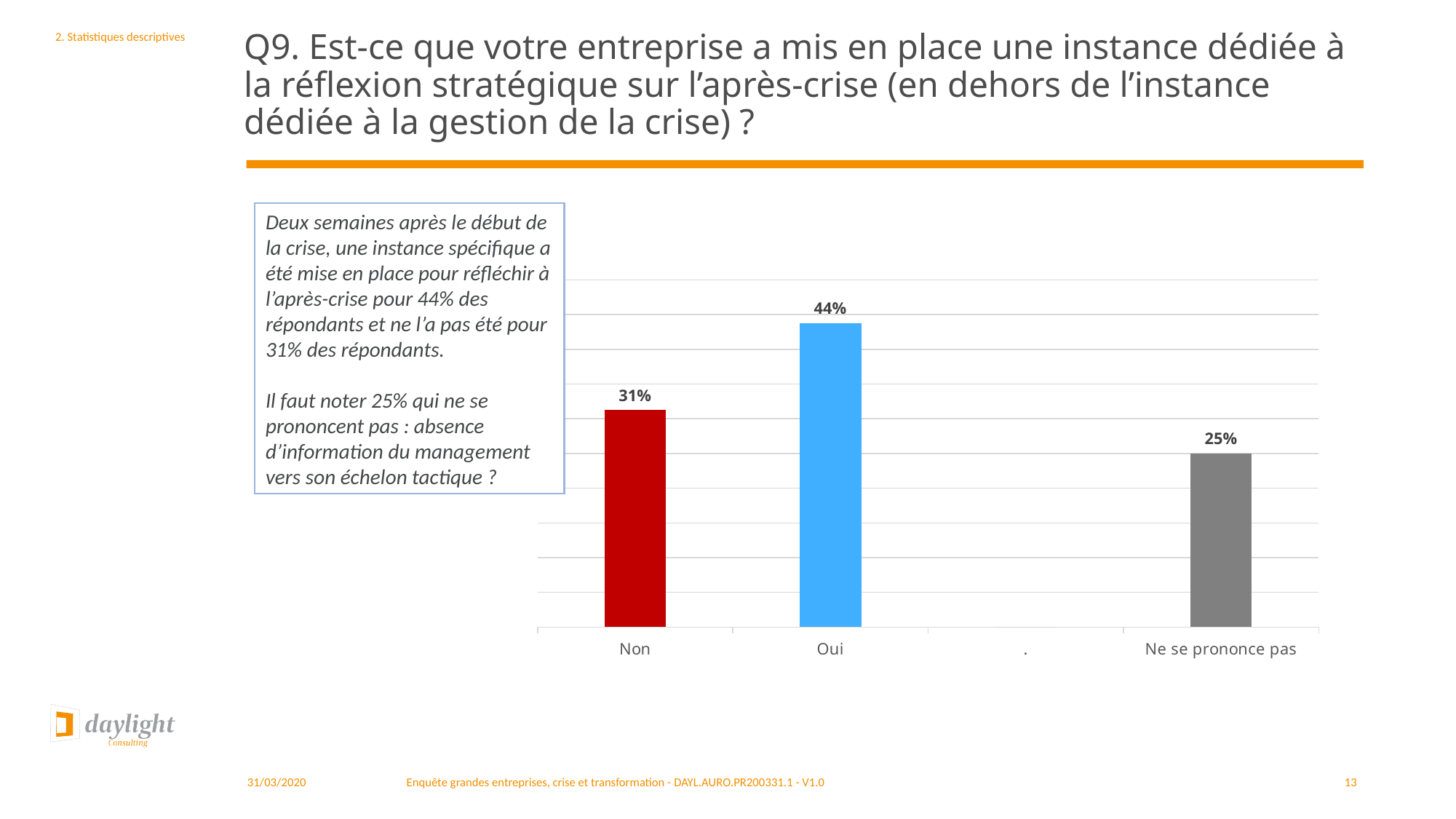
Which category has the lowest value among the plotted bars? Ne se prononce pas Which category has the highest value? Oui Which is larger, the value for "Non" or the value for "Ne se prononce pas"? Non What is the difference between the values for "Non" and "Ne se prononce pas"? 6% What is the value for "Ne se prononce pas"? 25% How many bars are plotted on the chart? 3 What colour is the bar for "Non"? Red What is the difference between the values for "Oui" and "Non"? 13% What colour is the bar for "Oui"? Blue What kind of chart is shown on the slide? Bar chart What is the value for "Oui"? 44% What is the value for "Non"? 31%